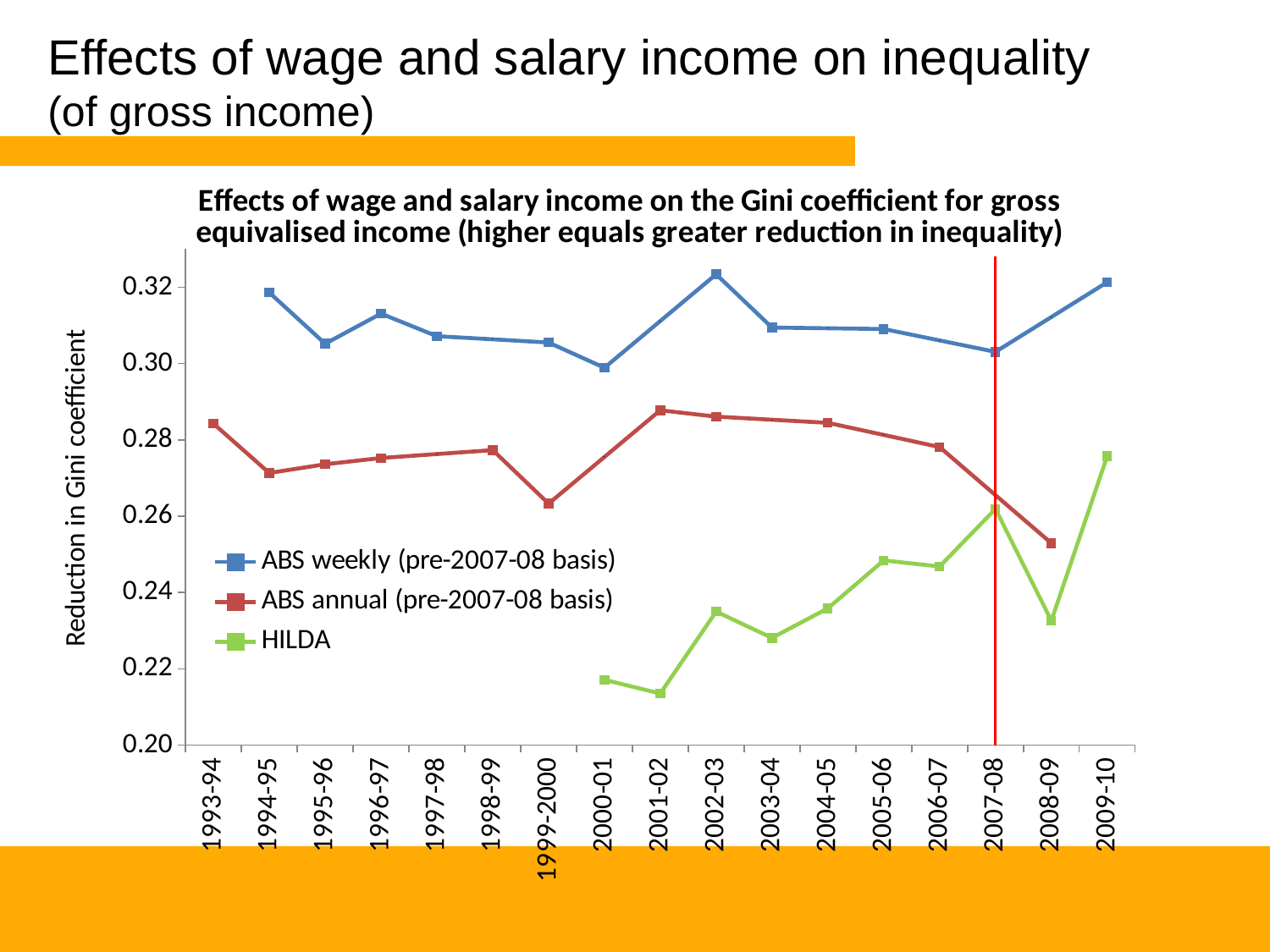
In which year is the ABS annual (pre-2007-08 basis) series at its lowest? 2008-09 Is the value for HILDA in 2009-10 greater or less than 0.26? greater What kind of chart is shown on the slide? Line chart Which series has the larger value in 2005-06, ABS weekly (pre-2007-08 basis) or ABS annual (pre-2007-08 basis)? ABS weekly (pre-2007-08 basis) Is the value for HILDA in 2001-02 greater or less than 0.22? less What is the label on the vertical axis? Reduction in Gini coefficient How many year categories are shown on the x axis? 17 Is the value for ABS annual (pre-2007-08 basis) in 2008-09 greater or less than 0.26? less How many series does the legend list? 3 Does the ABS annual (pre-2007-08 basis) series rise or fall from 2004-05 to 2008-09? Fall In which year is the HILDA series at its highest? 2009-10